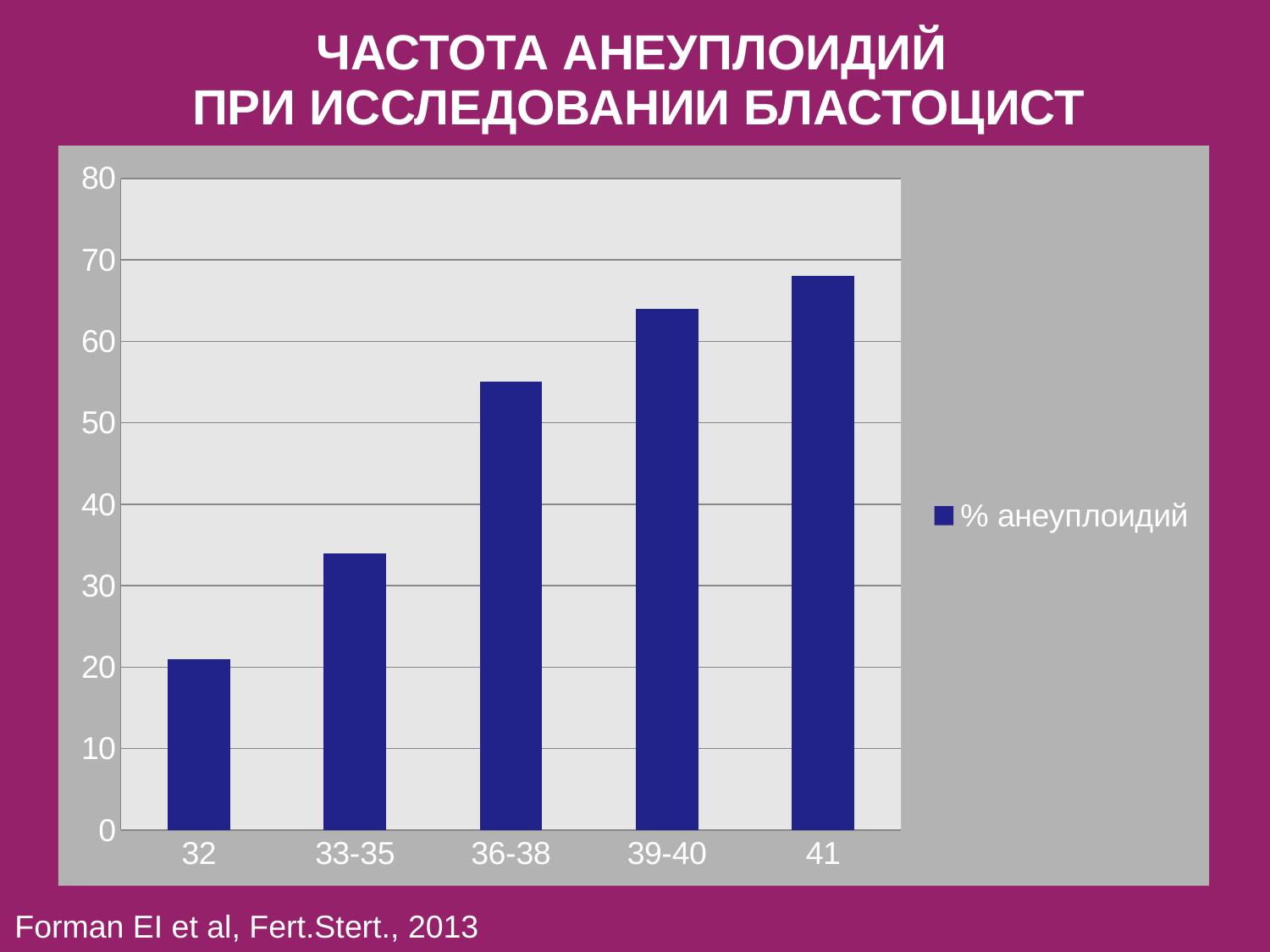
Which is larger, the value for 36-38 or the value for 33-35? 36-38 What kind of chart is shown on the slide? bar chart Which age category has the highest value? 41 Do the values rise or fall as the age categories increase along the x axis? rise What is the legend entry for the series shown? % анеуплоидий Is the value for 36-38 greater or less than 50? greater Is the value for 33-35 greater or less than 30? greater Is the value for 41 greater or less than 70? less Which age category has the lowest value? 32 How many series does the legend list? 1 How many age categories are shown on the x axis? 5